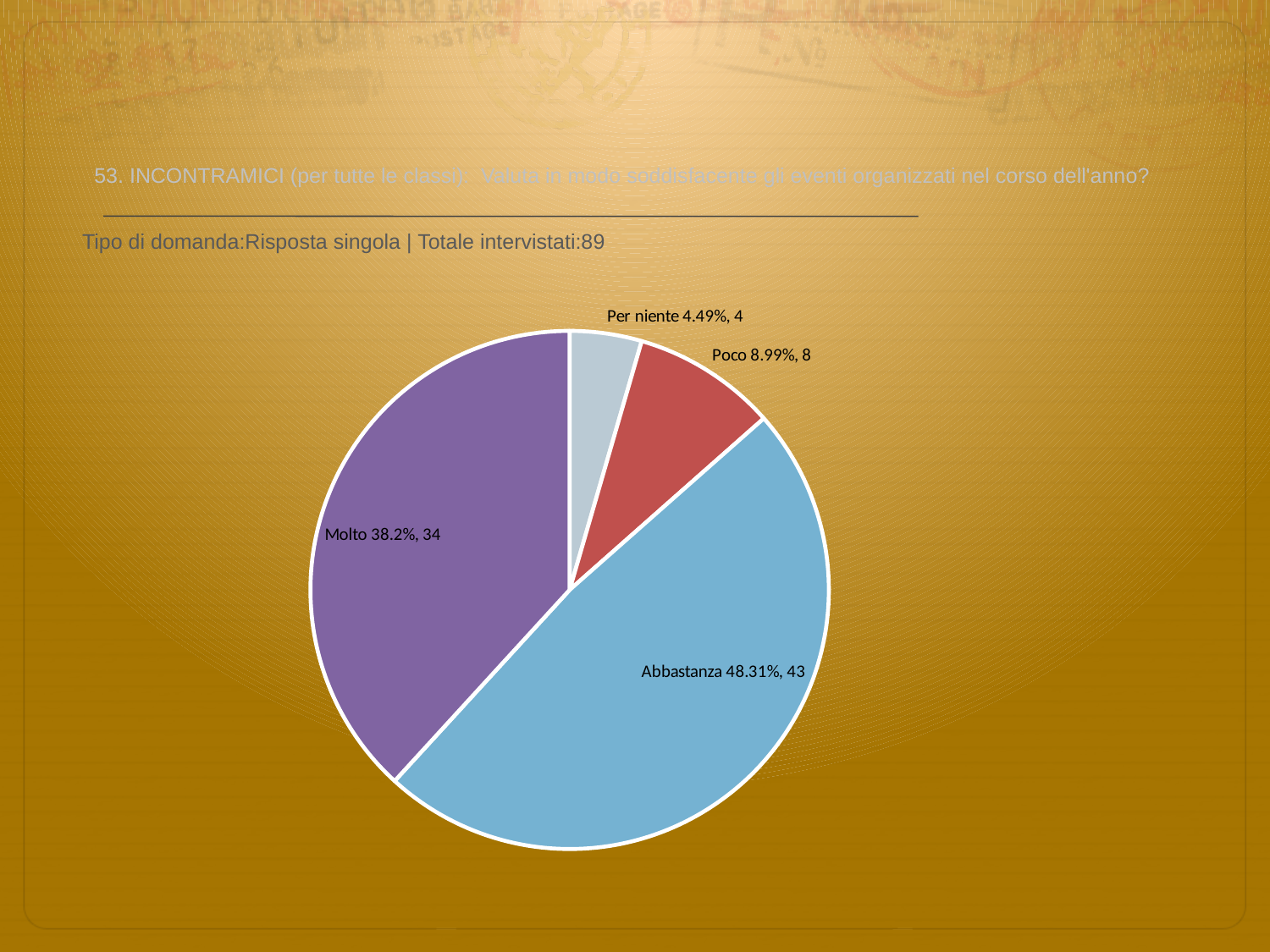
Which category has the largest slice? Abbastanza What colour is the 'Molto' slice? purple How many slices does the pie chart have? 4 What kind of chart is shown on the slide? pie chart What is the total number of respondents across all slices? 89 Which is larger, the count for 'Poco' or the count for 'Per niente'? Poco What percentage share does the 'Molto' slice have? 38.2% What is the difference in count between 'Abbastanza' and 'Molto'? 9 What percentage share does the 'Abbastanza' slice have? 48.31% What is the count shown for 'Per niente'? 4 Which category has the smallest slice? Per niente What is the count shown for 'Poco'? 8